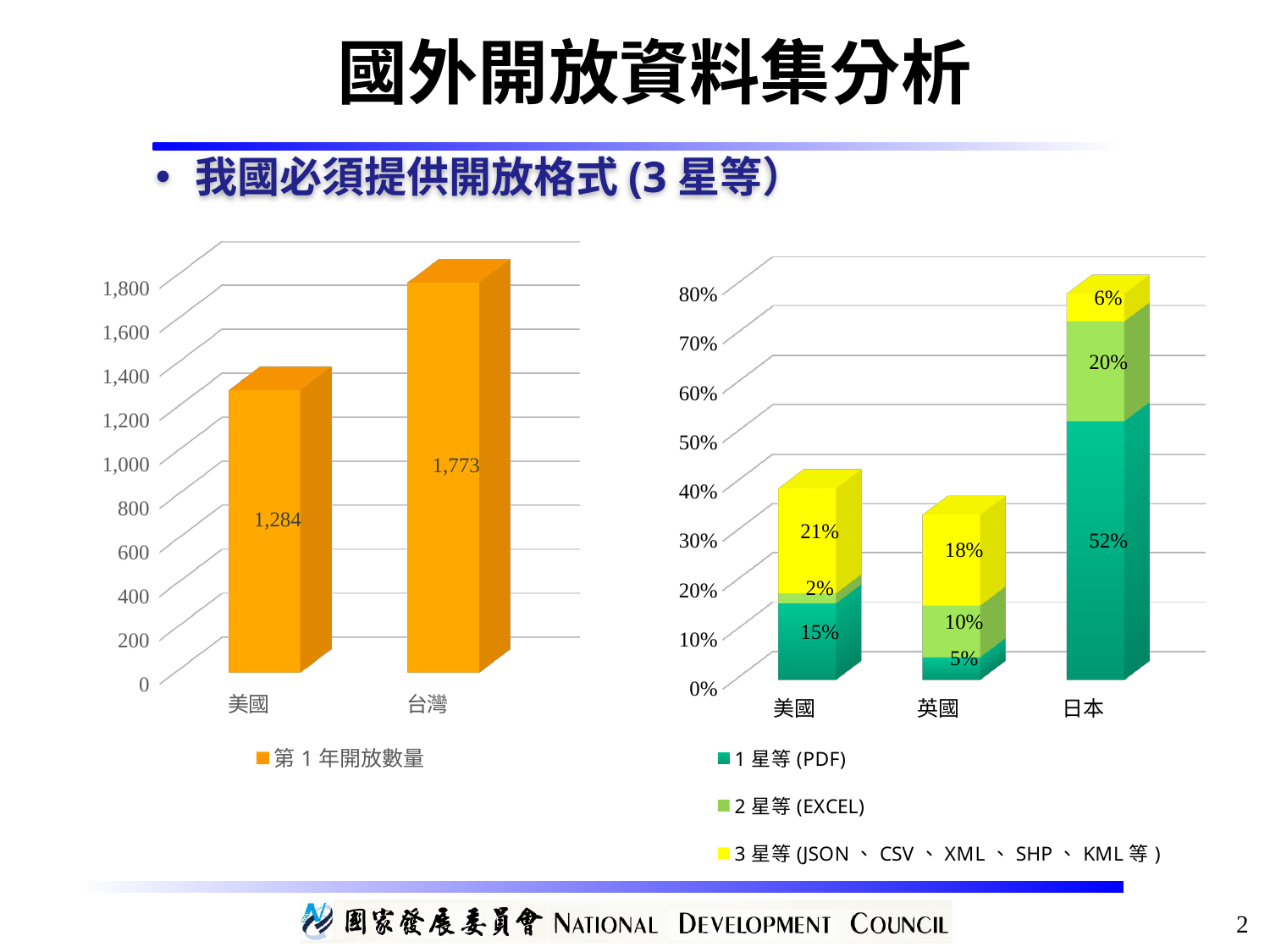
In the right chart, which country has the highest 1 星等 (PDF) value? 日本 In the right chart, what is the 3 星等 value for 英國? 18% In the right chart, what is the 2 星等 (EXCEL) value for 美國? 2% In the left chart, what is the difference between the values for 台灣 and 美國? 489 In the left chart, what is the value for 台灣? 1,773 In the right chart, what is the total of the stacked bar for 日本? 78% In the left chart, what is the value for 美國? 1,284 In the left chart, which category has the higher value, 美國 or 台灣? 台灣 In the right chart, what is the total of the stacked bar for 英國? 33% In the right chart, how many series does the legend list? 3 In the left chart, what series does the legend list? 第 1 年開放數量 In the right chart, what is the 1 星等 (PDF) value for 日本? 52%